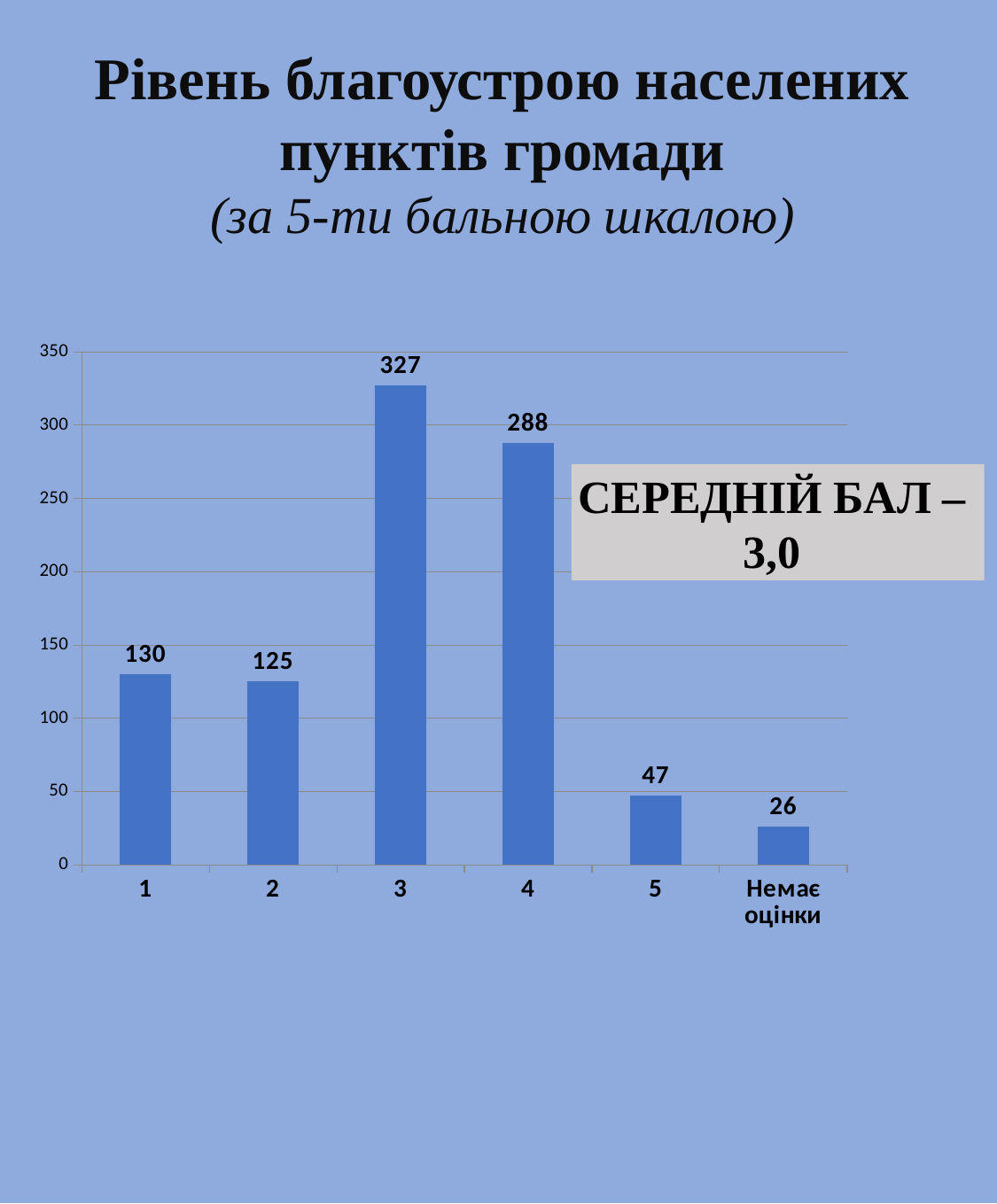
Is the value for category 4 greater or less than 250? greater What is the difference between the values for category 1 and category 2? 5 What is the value for the category "Немає оцінки"? 26 What kind of chart is shown on the slide? bar chart How many categories are shown on the x axis? 6 What is the difference between the values for category 3 and category 4? 39 What is the value for category 1? 130 Which category has the lowest value? Немає оцінки Which category has the highest value? 3 What is the value for category 3? 327 What average score (СЕРЕДНІЙ БАЛ) is stated in the box on the slide? 3,0 Which is larger, the value for category 4 or the value for category 5? 4